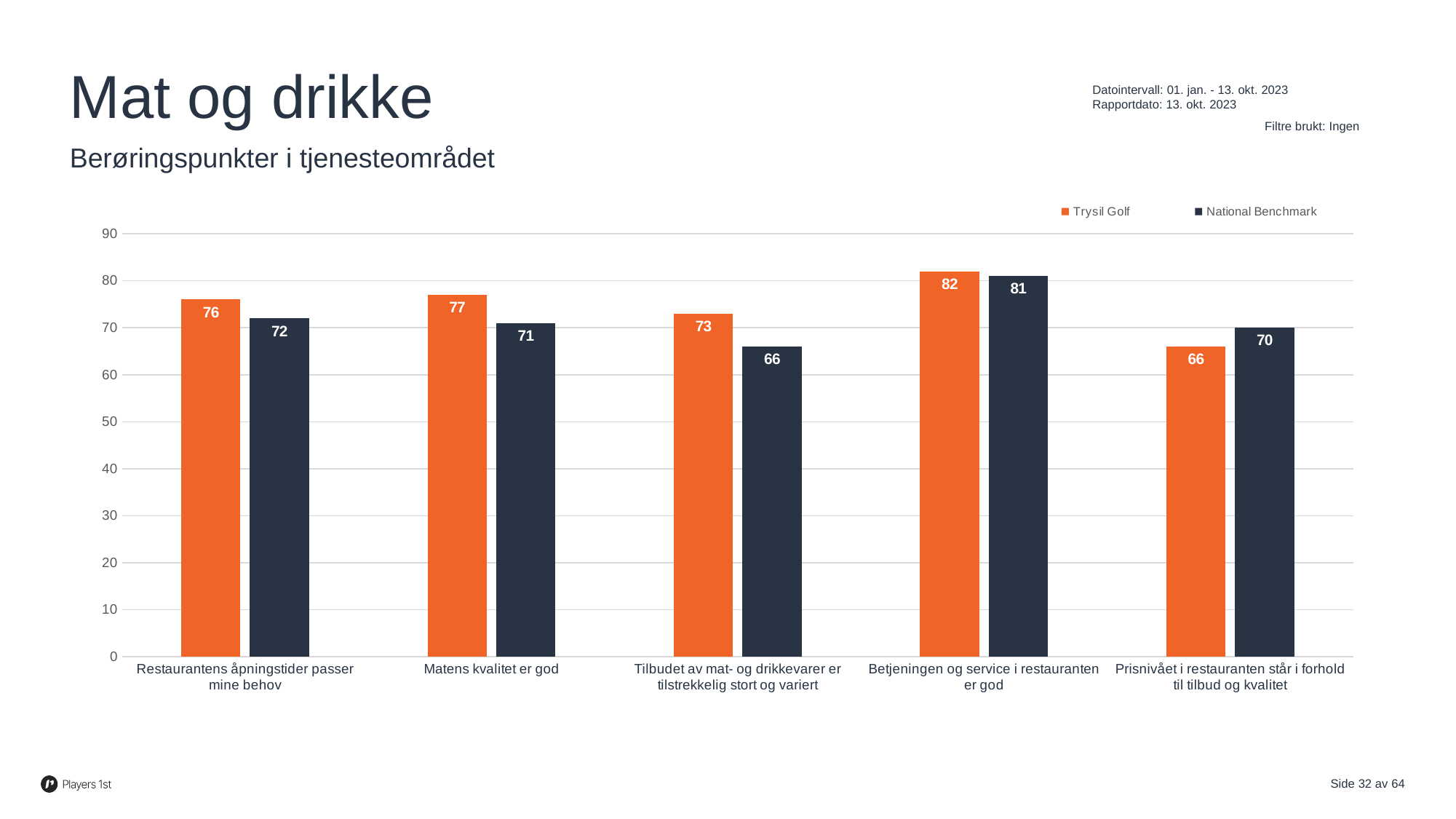
How many categories are shown on the x axis? 5 What is the National Benchmark value for "Tilbudet av mat- og drikkevarer er tilstrekkelig stort og variert"? 66 What is the Trysil Golf value for "Matens kvalitet er god"? 77 Which category has the highest Trysil Golf value? Betjeningen og service i restauranten er god What is the Trysil Golf value for "Prisnivået i restauranten står i forhold til tilbud og kvalitet"? 66 Is the Trysil Golf value for "Betjeningen og service i restauranten er god" greater or less than 80? greater What kind of chart is shown on the slide? Bar chart Which colour represents Trysil Golf in the chart? Orange How many series does the legend list? 2 Which category has the lowest National Benchmark value? Tilbudet av mat- og drikkevarer er tilstrekkelig stort og variert What is the difference between the Trysil Golf and National Benchmark values for "Tilbudet av mat- og drikkevarer er tilstrekkelig stort og variert"? 7 For "Prisnivået i restauranten står i forhold til tilbud og kvalitet", which is larger: Trysil Golf or National Benchmark? National Benchmark